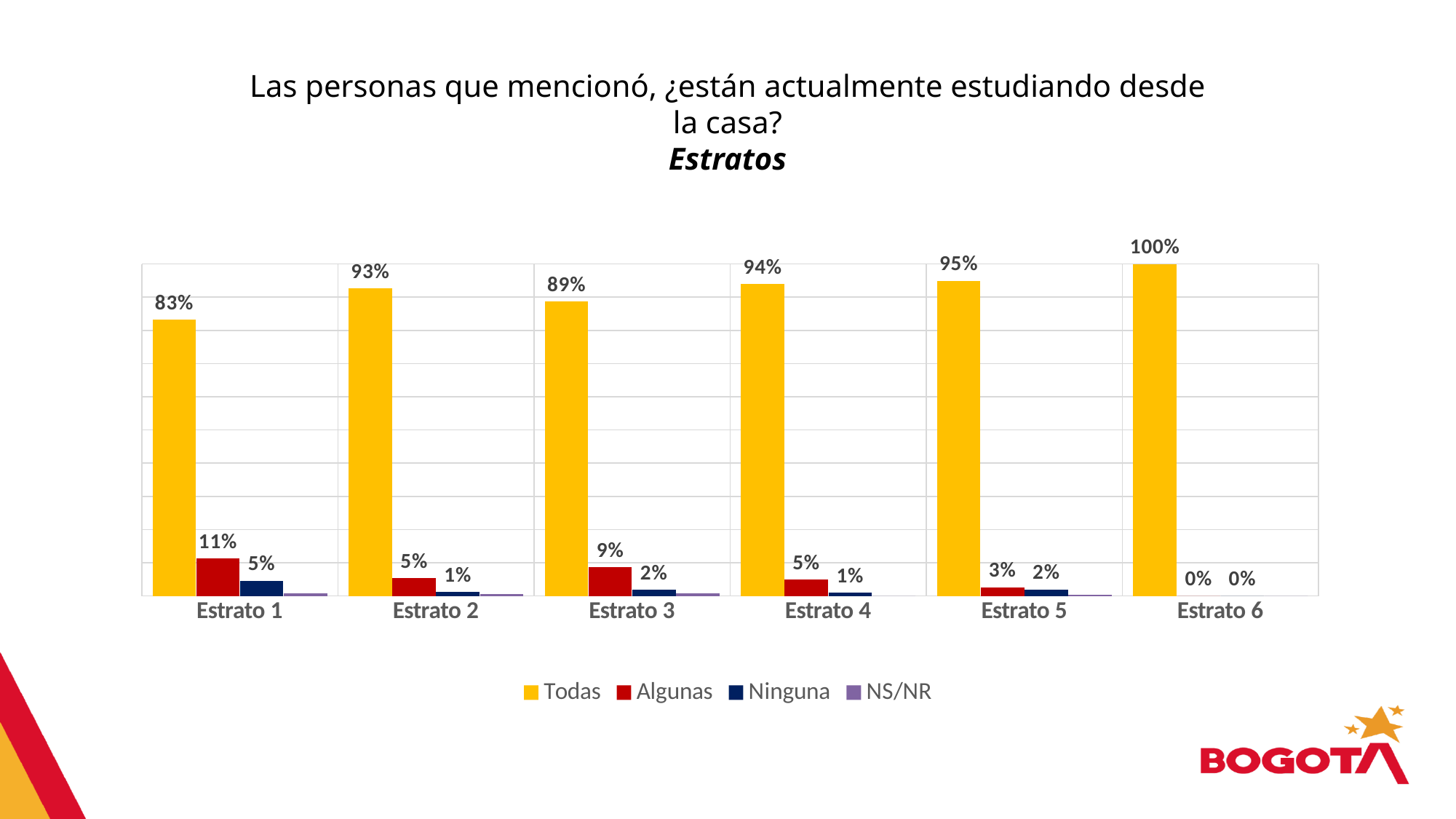
Which estrato has the highest value for Todas? Estrato 6 How many series does the legend list? 4 What is the difference between the Todas values for Estrato 6 and Estrato 1? 17% What kind of chart is shown on the slide? Bar chart What is the value for Algunas in Estrato 3? 9% Which estrato has the highest value for Algunas? Estrato 1 Which estrato has the lowest value for Todas? Estrato 1 Which colour represents the Todas series in the legend? Yellow What is the value for Todas in Estrato 1? 83% How many estratos are shown on the x axis? 6 Which is larger, the Algunas value for Estrato 1 or for Estrato 3? Estrato 1 What is the value for Ninguna in Estrato 5? 2%